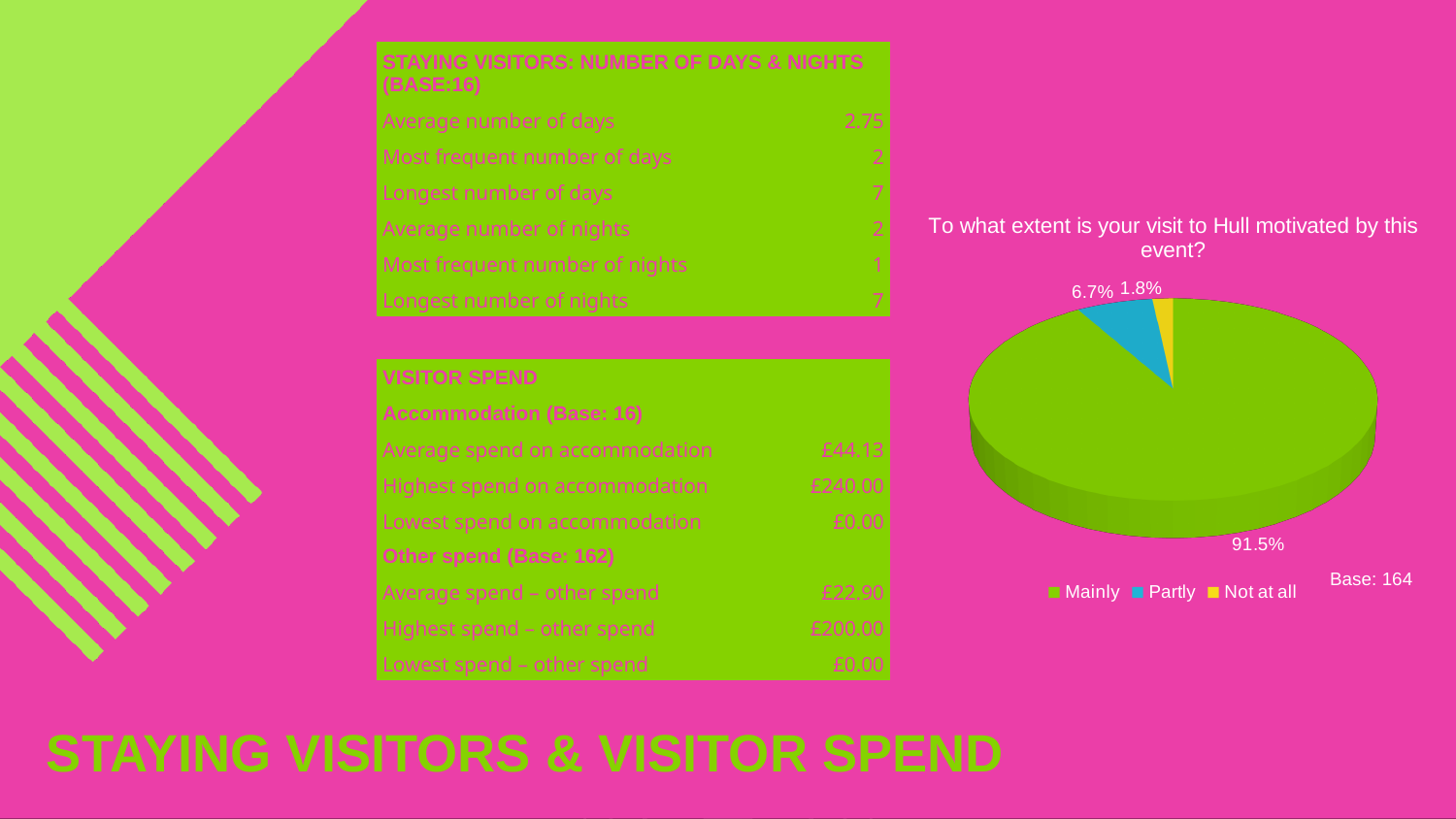
Is the share for 'Mainly' greater or less than 90%? greater What share of the pie is labelled for 'Mainly'? 91.5% What share of the pie is labelled for 'Not at all'? 1.8% Which category has the largest slice of the pie? Mainly What kind of chart is shown on the slide? pie chart Which category has the smallest slice of the pie? Not at all What base (number of respondents) is stated for the pie chart? 164 What share of the pie is labelled for 'Partly'? 6.7% Which slice is larger, 'Partly' or 'Not at all'? Partly What is the difference in percentage points between the 'Mainly' and 'Partly' slices? 84.8 How many categories does the pie chart legend list? 3 What is the title of the pie chart? To what extent is your visit to Hull motivated by this event?